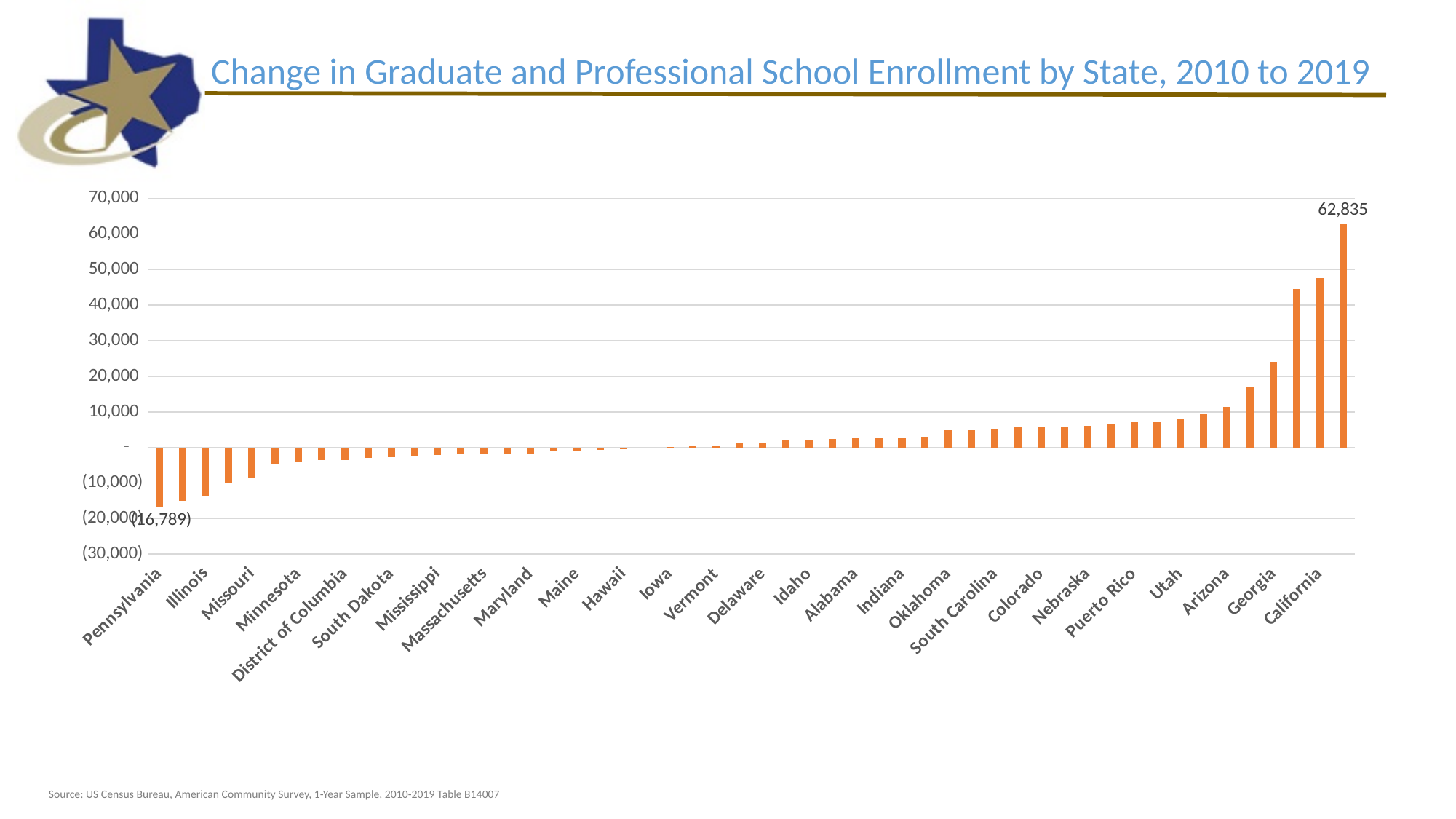
Which state has the lowest change in graduate and professional school enrollment? Pennsylvania Do the values rise or fall moving from left to right along the x axis? Rise What is the value for Pennsylvania? (16,789) Is the value for Arizona greater or less than 10,000? greater What kind of chart is shown on the slide? Bar chart Which is larger, the value for Illinois or the value for Pennsylvania? Illinois Is the value for Georgia greater or less than 40,000? less Is the value for Illinois greater or less than (10,000)? less Which is larger, the value for California or the value for Georgia? California